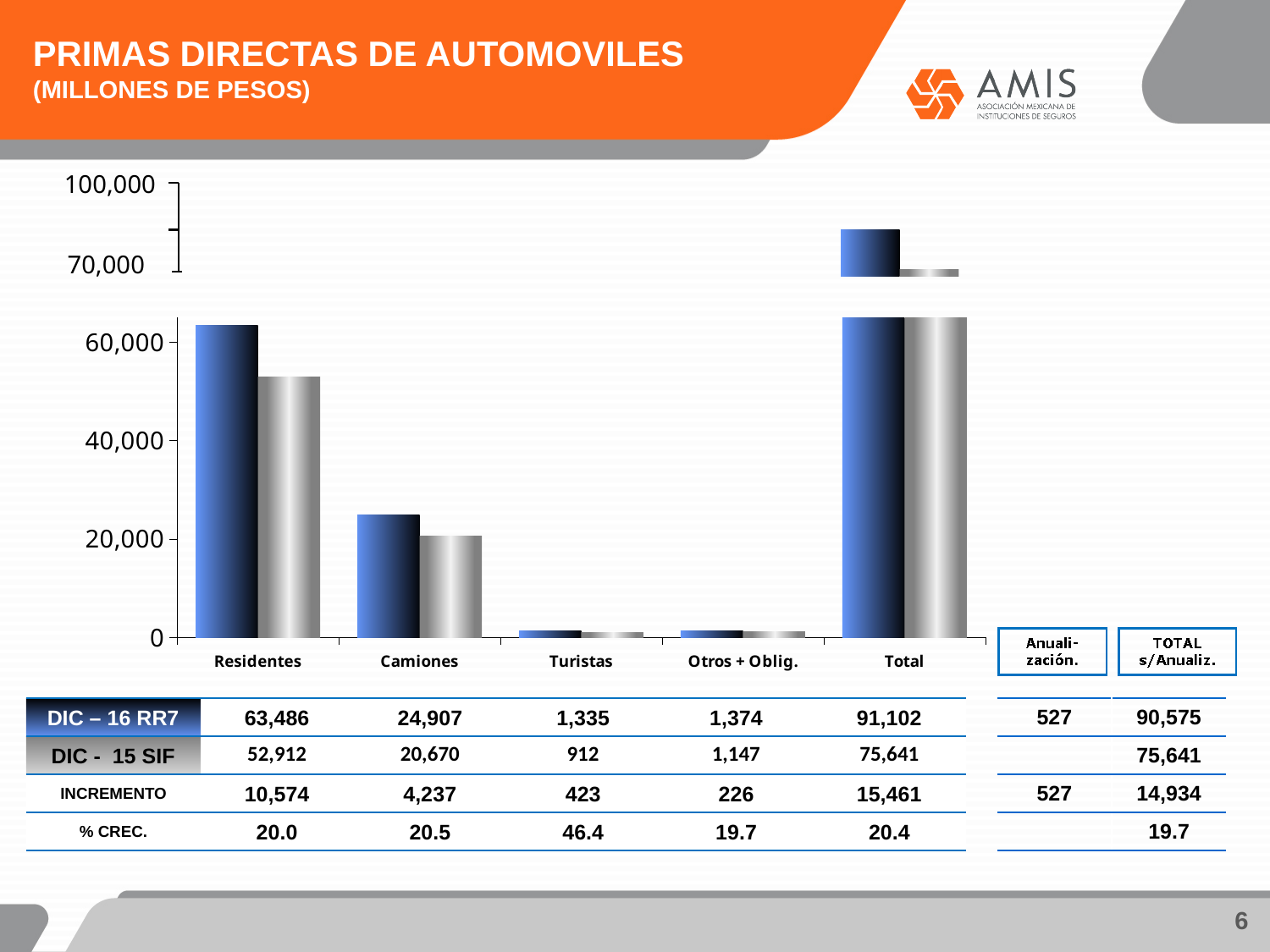
What is the title of the chart on the slide? PRIMAS DIRECTAS DE AUTOMOVILES (MILLONES DE PESOS) Is the DIC – 16 RR7 value for Total greater or less than 70,000? greater Which is larger for Camiones, the DIC – 16 RR7 value or the DIC - 15 SIF value? DIC – 16 RR7 Which category has the lowest DIC - 15 SIF value? Turistas What is the DIC - 15 SIF value for Camiones? 20,670 What is the DIC – 16 RR7 value for Residentes? 63,486 What is the difference between the DIC – 16 RR7 and DIC - 15 SIF values for Residentes? 10,574 Excluding Total, which category has the highest DIC – 16 RR7 value? Residentes What is the DIC - 15 SIF value for Otros + Oblig.? 1,147 What is the DIC – 16 RR7 value for Turistas? 1,335 What type of chart is shown on the slide? bar chart How many categories are shown on the x axis of the chart? 5